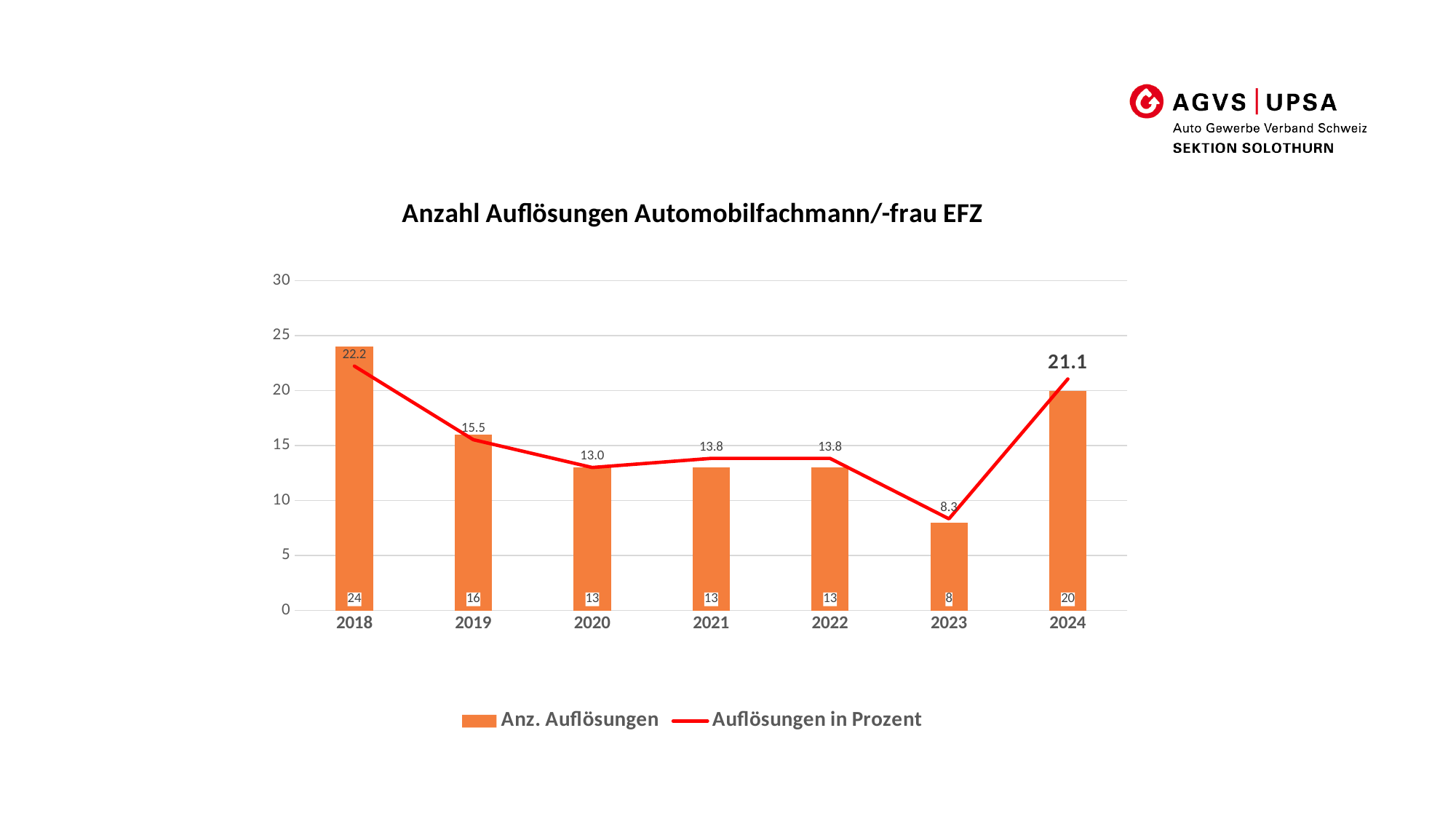
What is the value of Auflösungen in Prozent for 2019? 15.5 What is the value of Anz. Auflösungen for 2018? 24 What kind of chart is used for the Anz. Auflösungen series? bar chart What is the value of Anz. Auflösungen for 2023? 8 Which year has the lowest Auflösungen in Prozent? 2023 How many series does the legend list? 2 Which is larger, the Auflösungen in Prozent for 2018 or for 2024? 2018 What is the value of Auflösungen in Prozent for 2024? 21.1 Which year has the highest Anz. Auflösungen? 2018 What is the difference in Anz. Auflösungen between 2018 and 2023? 16 What is the title of the chart? Anzahl Auflösungen Automobilfachmann/-frau EFZ How many years are shown on the x axis? 7